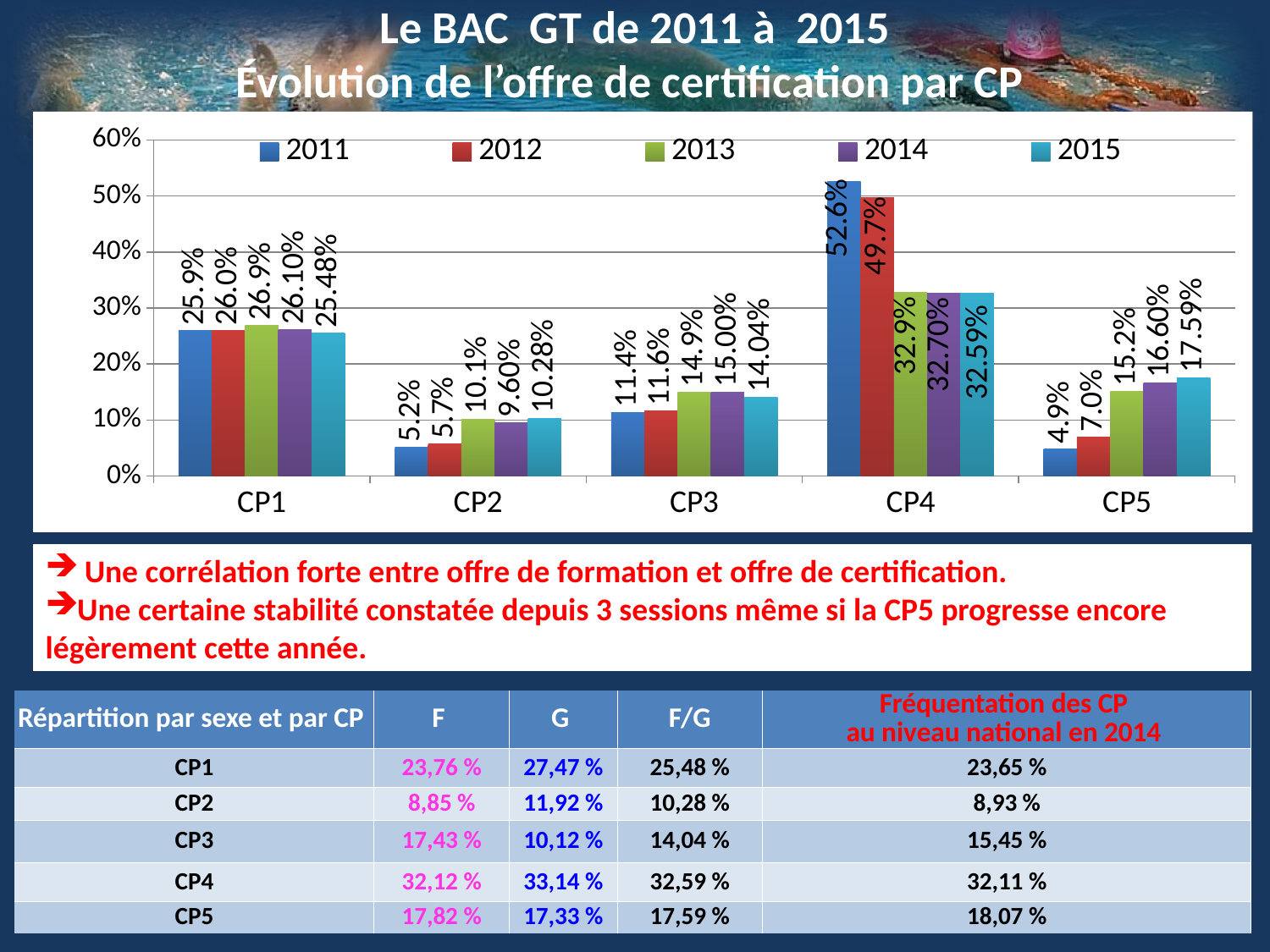
Which is larger for CP3: the 2013 value or the 2015 value? 2013 Do the values for CP5 rise or fall from 2011 to 2015? rise What is the difference between the 2011 and 2012 values for CP4? 2.9% Which category has the lowest value in 2011? CP5 What kind of chart is shown on the slide? bar chart What is the value for CP4 in 2011? 52.6% Which category has the highest value in 2012? CP4 What is the value for CP2 in 2013? 10.1% What is the value for CP5 in 2015? 17.59% How many series does the legend list? 5 Is the value for CP1 in 2013 greater or less than 20%? greater How many categories are shown on the x axis? 5